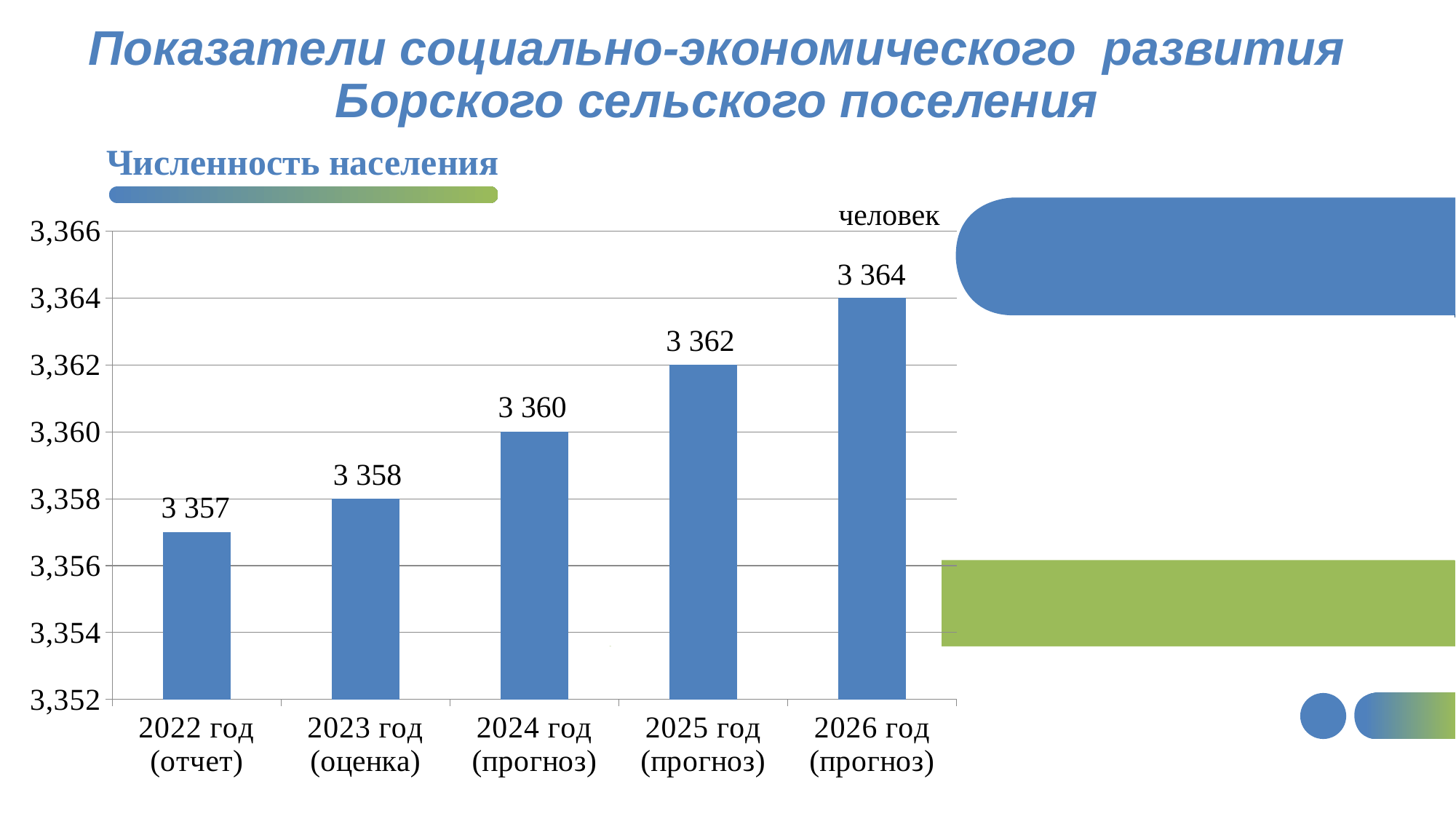
What is the difference between the values for 2026 год (прогноз) and 2022 год (отчет)? 7 What is the population value shown for 2026 год (прогноз)? 3 364 Which year has the lowest population value? 2022 год (отчет) What kind of chart is shown on the slide? bar chart What is the population value shown for 2024 год (прогноз)? 3 360 Which year has the highest population value? 2026 год (прогноз) What is the population value shown for 2022 год (отчет)? 3 357 Which is larger, the value for 2023 год (оценка) or the value for 2025 год (прогноз)? 2025 год (прогноз) What is the difference between the values for 2025 год (прогноз) and 2023 год (оценка)? 4 How many years (bars) are shown in the chart? 5 Do the values rise or fall from 2022 to 2026? rise What is the title of the chart? Численность населения